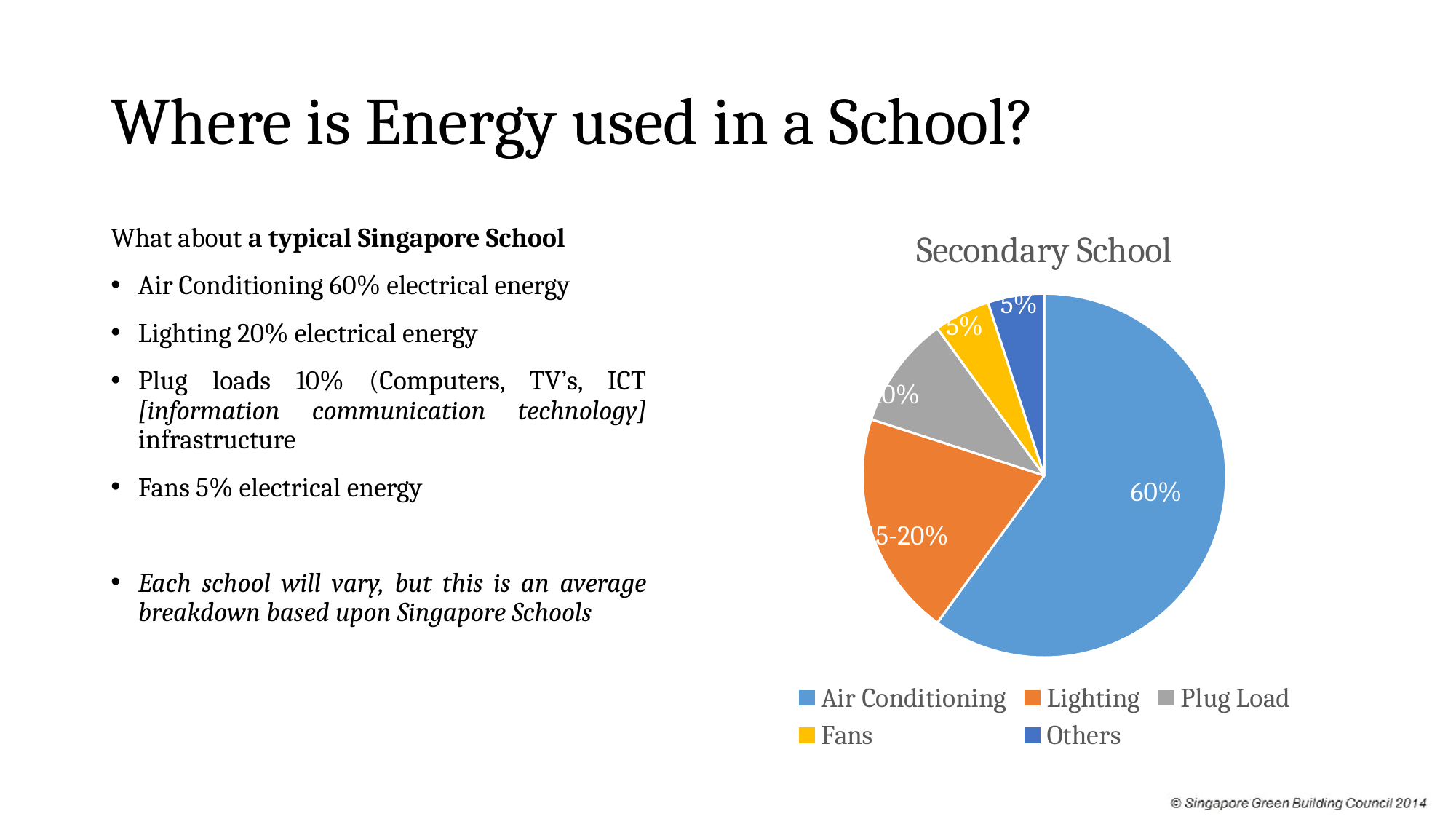
What share of the pie does Air Conditioning take? 60% Which slice is larger, Plug Load or Fans? Plug Load Which slice is larger, Lighting or Plug Load? Lighting What kind of chart is shown on the slide? pie chart How many categories does the pie chart show? 5 What is the difference between the Air Conditioning share and the Fans share? 55% What share of the pie does Fans take? 5% What is the title of the pie chart? Secondary School Which slice is larger, Air Conditioning or Lighting? Air Conditioning What colour is the Air Conditioning slice in the pie chart? blue What share of the pie does Others take? 5% Which category has the largest slice of the pie? Air Conditioning